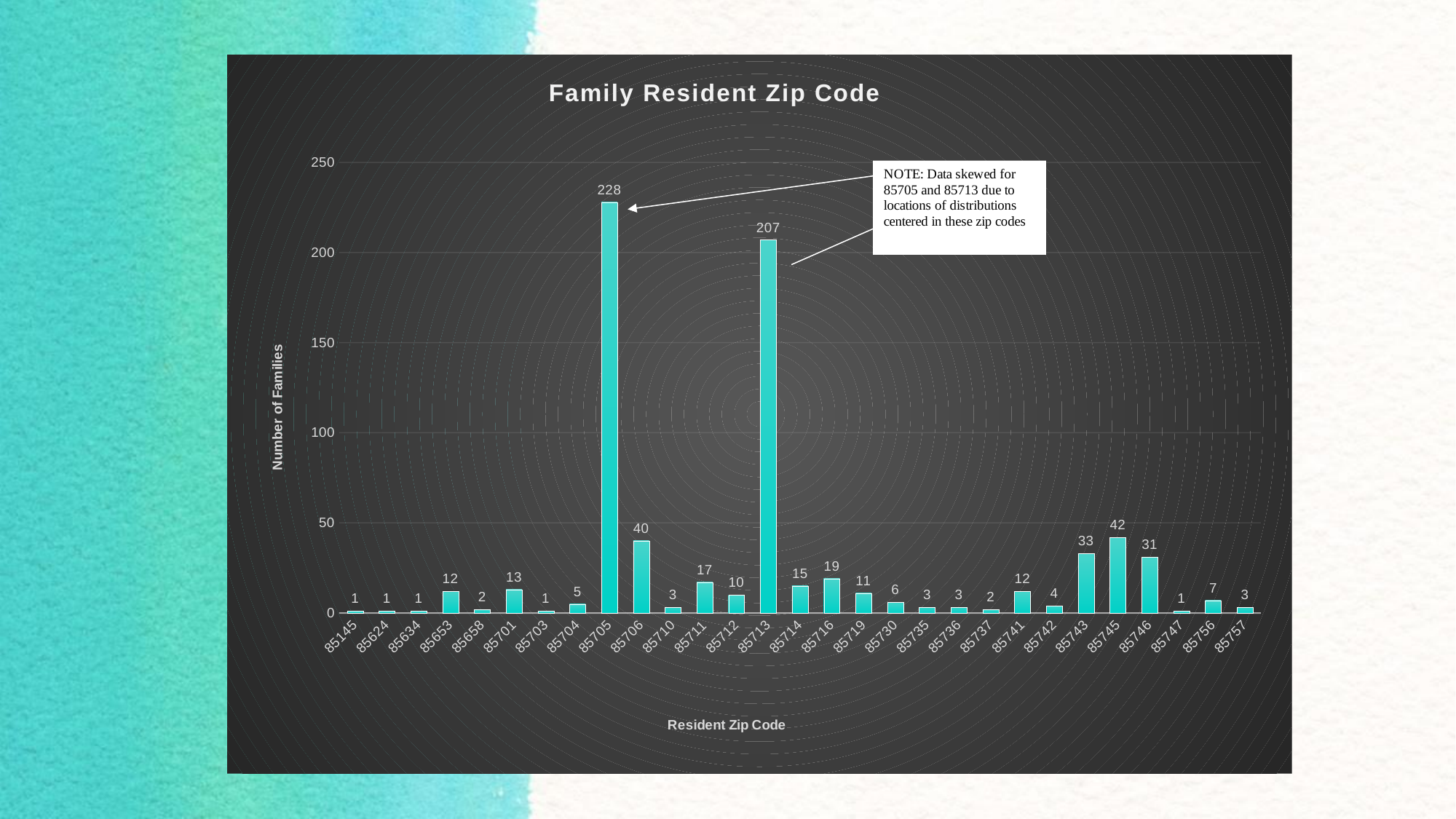
What is the number of families for zip code 85713? 207 Which zip code has more families, 85706 or 85746? 85706 What is the number of families for zip code 85705? 228 Is the number of families for zip code 85713 greater or less than 200? greater What is the number of families for zip code 85745? 42 How many zip codes are shown on the x axis of the chart? 29 Which zip code has the highest number of families? 85705 What type of chart is shown on the slide? bar chart What is the difference in number of families between zip codes 85745 and 85743? 9 What is the number of families for zip code 85711? 17 What is the title of the chart? Family Resident Zip Code What is the difference in number of families between zip codes 85705 and 85713? 21